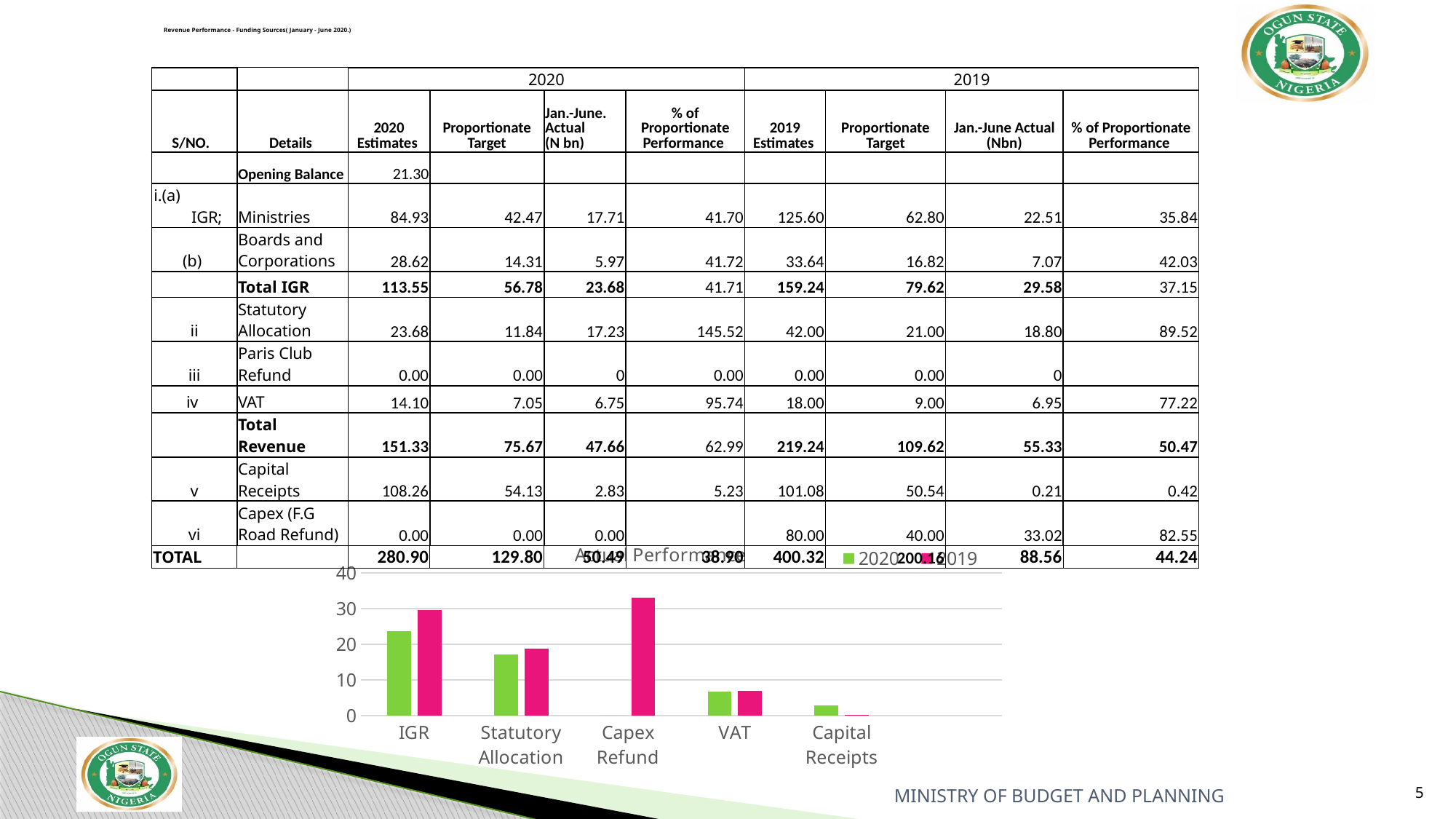
In the bar chart, is the 2019 value for Capex Refund greater or less than 30? greater In the bar chart, which category has the highest value for the 2019 series? Capex Refund What colour are the bars for the 2020 series in the bar chart? green In the bar chart, which category has the lowest value for the 2019 series? Capital Receipts In the bar chart, is the 2020 value for Statutory Allocation greater or less than 20? less What kind of chart is shown on the slide? bar chart In the bar chart, for Capital Receipts, which series has the larger value, 2020 or 2019? 2020 How many series does the legend of the bar chart list? 2 How many categories are shown on the x axis of the bar chart? 5 In the bar chart, which category has the highest value for the 2020 series? IGR In the bar chart, is the 2020 value for IGR greater or less than 20? greater In the bar chart, for IGR, which series has the larger value, 2020 or 2019? 2019